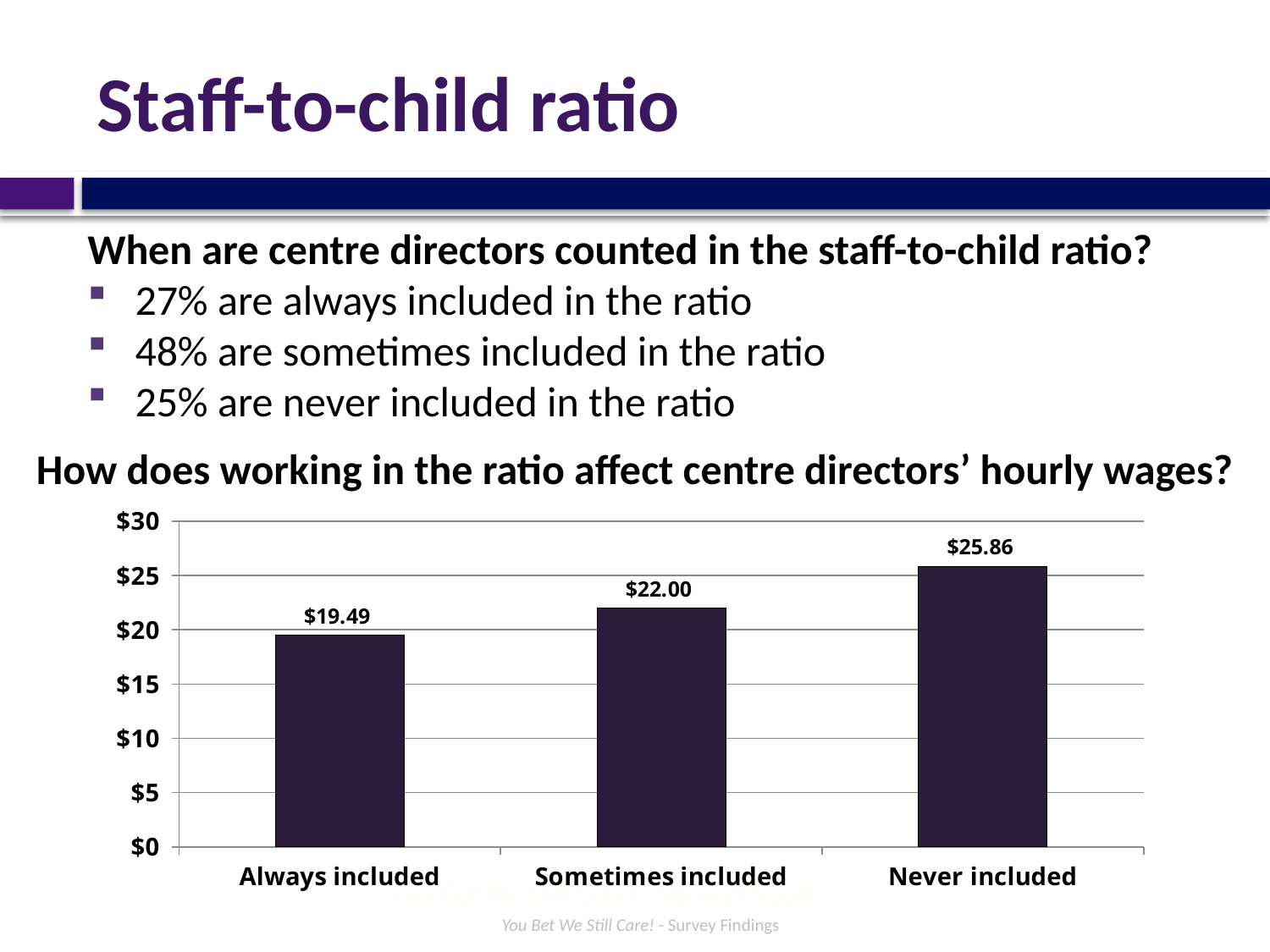
Which category has the highest hourly wage? Never included What is the hourly wage for centre directors who are Always included in the ratio? $19.49 How many categories are shown on the chart? 3 What is the hourly wage for centre directors who are Never included in the ratio? $25.86 Is the hourly wage for Always included greater or less than $20? less What is the hourly wage for centre directors who are Sometimes included in the ratio? $22.00 What is the difference in hourly wage between Sometimes included and Always included? $2.51 Which has a higher hourly wage, Sometimes included or Never included? Never included Which category has the lowest hourly wage? Always included What is the difference in hourly wage between Never included and Always included? $6.37 Do the hourly wages rise or fall from Always included to Never included? rise What kind of chart is shown on the slide? bar chart